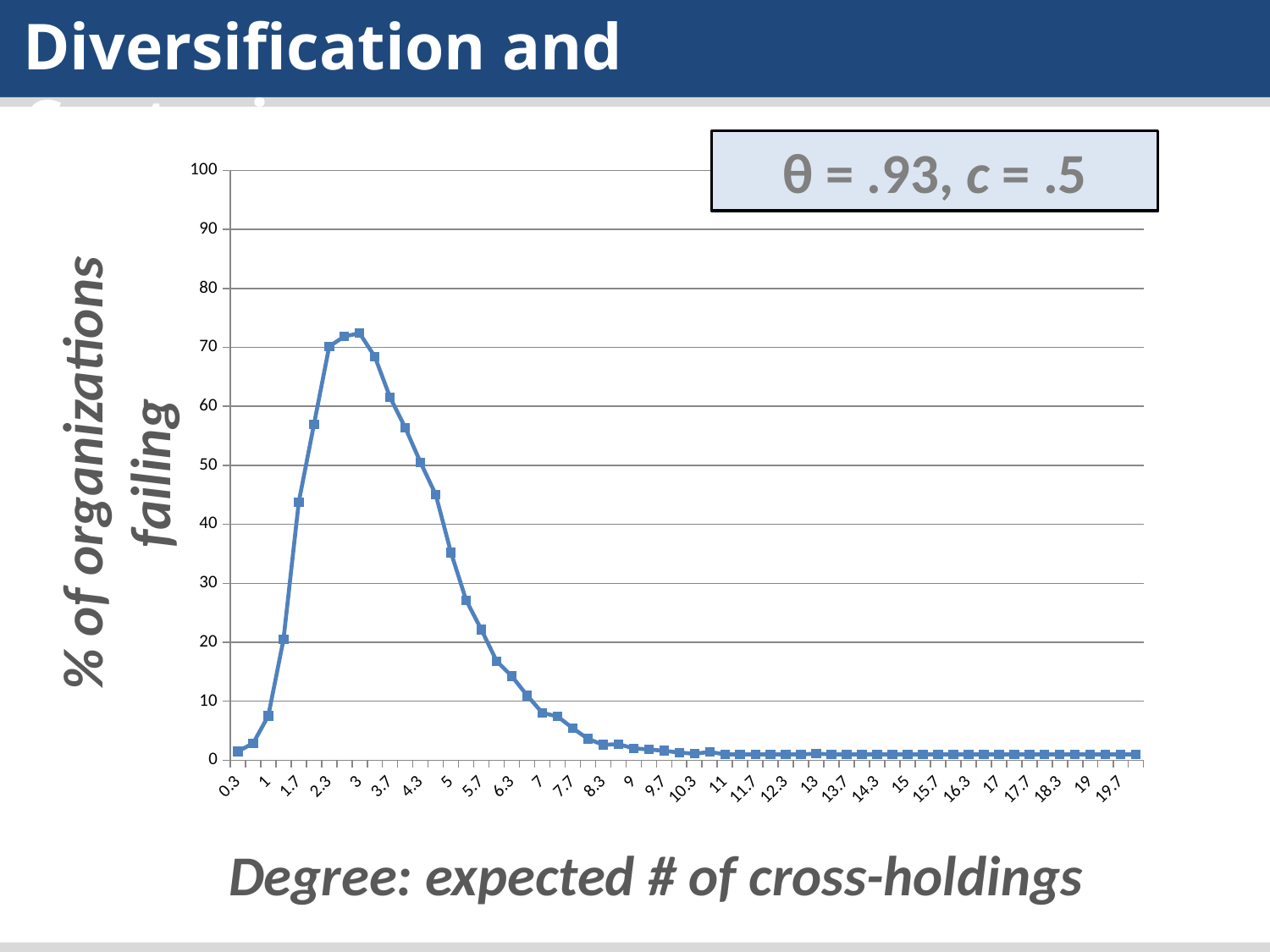
Do the values rise or fall along the x axis from degree 3 to degree 19.7? fall Is the value for degree 3.7 greater or less than 50? greater What is the title of the y axis? % of organizations failing What is the title of the x axis? Degree: expected # of cross-holdings What kind of chart is shown on the slide? line chart Around which degree value on the x axis does the curve reach its peak? 3 Is the value for degree 1.7 greater or less than 40? greater Is the value for degree 11 greater or less than 10? less Which is larger, the value at degree 5 or the value at degree 9? degree 5